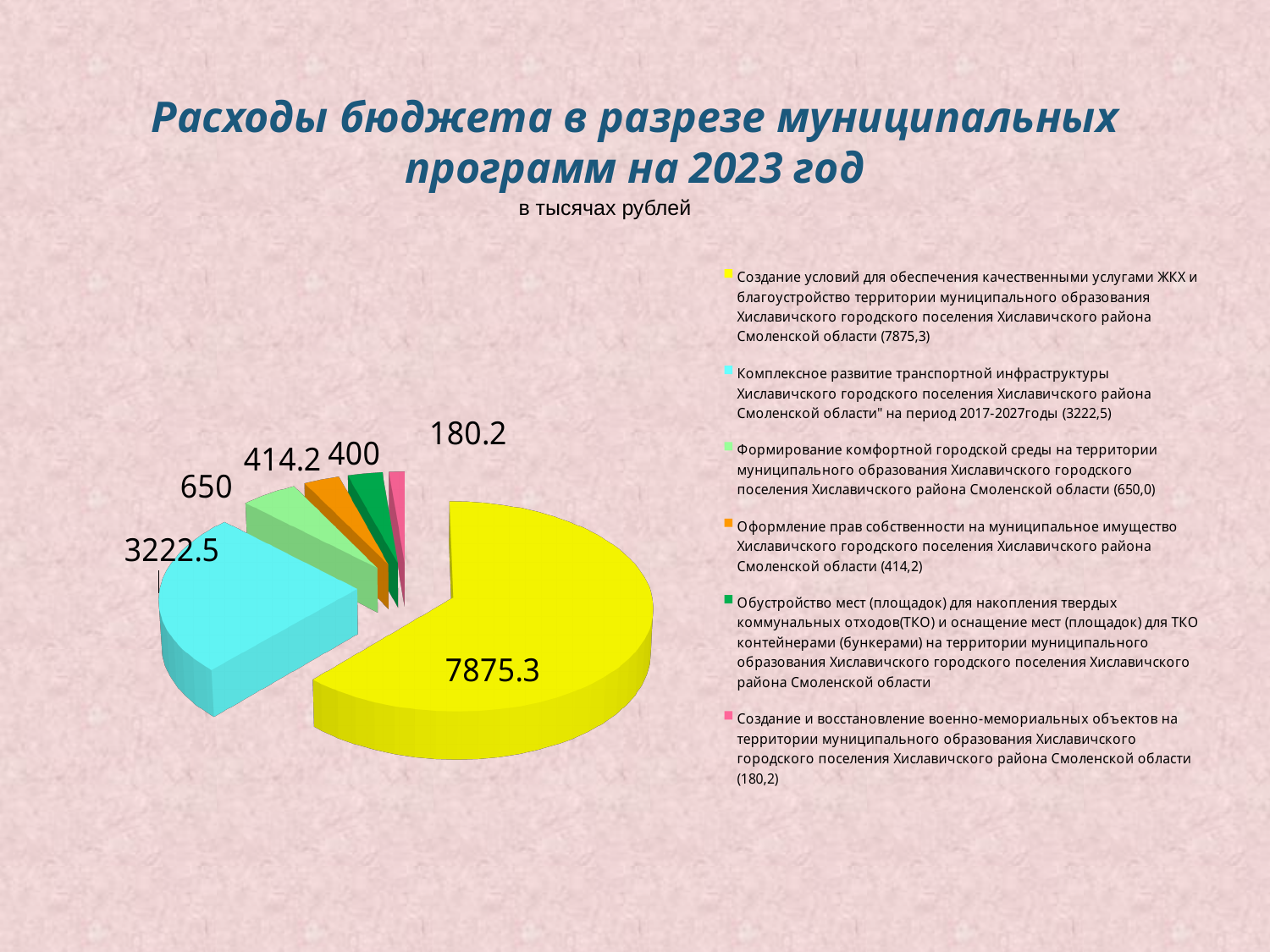
Which program has the smallest slice of the pie? Создание и восстановление военно-мемориальных объектов What is the value of the slice for «Комплексное развитие транспортной инфраструктуры»? 3222.5 What is the value of the slice for «Обустройство мест (площадок) для накопления твердых коммунальных отходов (ТКО)»? 400 What kind of chart is shown on the slide? pie chart Which is larger: the slice for «Формирование комфортной городской среды» or the slice for «Оформление прав собственности на муниципальное имущество»? Формирование комфортной городской среды Which program has the largest slice of the pie? Создание условий для обеспечения качественными услугами ЖКХ и благоустройство территории How many entries does the legend list? 6 In what units are the values on the chart given, according to the subtitle? в тысячах рублей How many slices does the pie chart have? 6 What is the total of all slices in the pie chart? 12742.2 What is the value of the slice for «Оформление прав собственности на муниципальное имущество»? 414.2 What is the difference between the largest slice (7875.3) and the slice for «Комплексное развитие транспортной инфраструктуры» (3222.5)? 4652.8